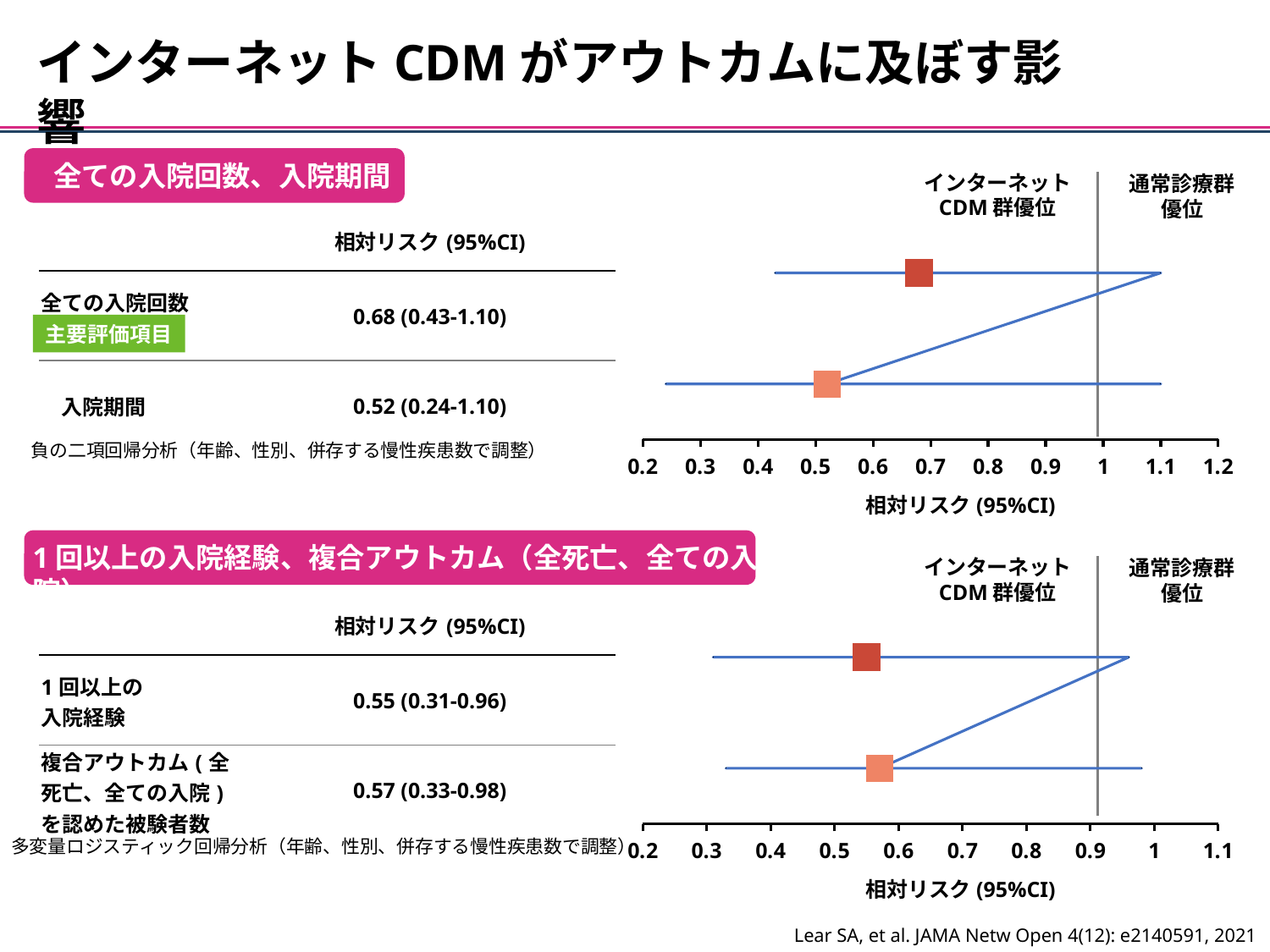
In the top chart (全ての入院回数、入院期間), what is the relative risk (95%CI) for 全ての入院回数? 0.68 (0.43-1.10) What kind of chart is used in the top chart to show the relative risks with confidence intervals? Forest plot In the top chart (全ての入院回数、入院期間), what is the relative risk (95%CI) for 入院期間? 0.52 (0.24-1.10) How many outcomes (data points) are plotted in the top chart? 2 In the bottom chart, is the relative risk point estimate for 1回以上の入院経験 greater or less than 0.6? less In the bottom chart (1回以上の入院経験、複合アウトカム), what is the relative risk (95%CI) for 1回以上の入院経験? 0.55 (0.31-0.96) In the top chart, what is the difference between the relative risk point estimates for 全ての入院回数 and 入院期間? 0.16 In the top chart, which outcome has the lower relative risk point estimate, 全ての入院回数 or 入院期間? 入院期間 In the bottom chart (1回以上の入院経験、複合アウトカム), what is the relative risk (95%CI) for 複合アウトカム（全死亡、全ての入院）を認めた被験者数? 0.57 (0.33-0.98) In the top chart, is the relative risk point estimate for 全ての入院回数 greater or less than 1? less What is the x-axis label of the bottom chart? 相対リスク (95%CI) In the bottom chart, what is the difference between the relative risk point estimates for 複合アウトカム and 1回以上の入院経験? 0.02